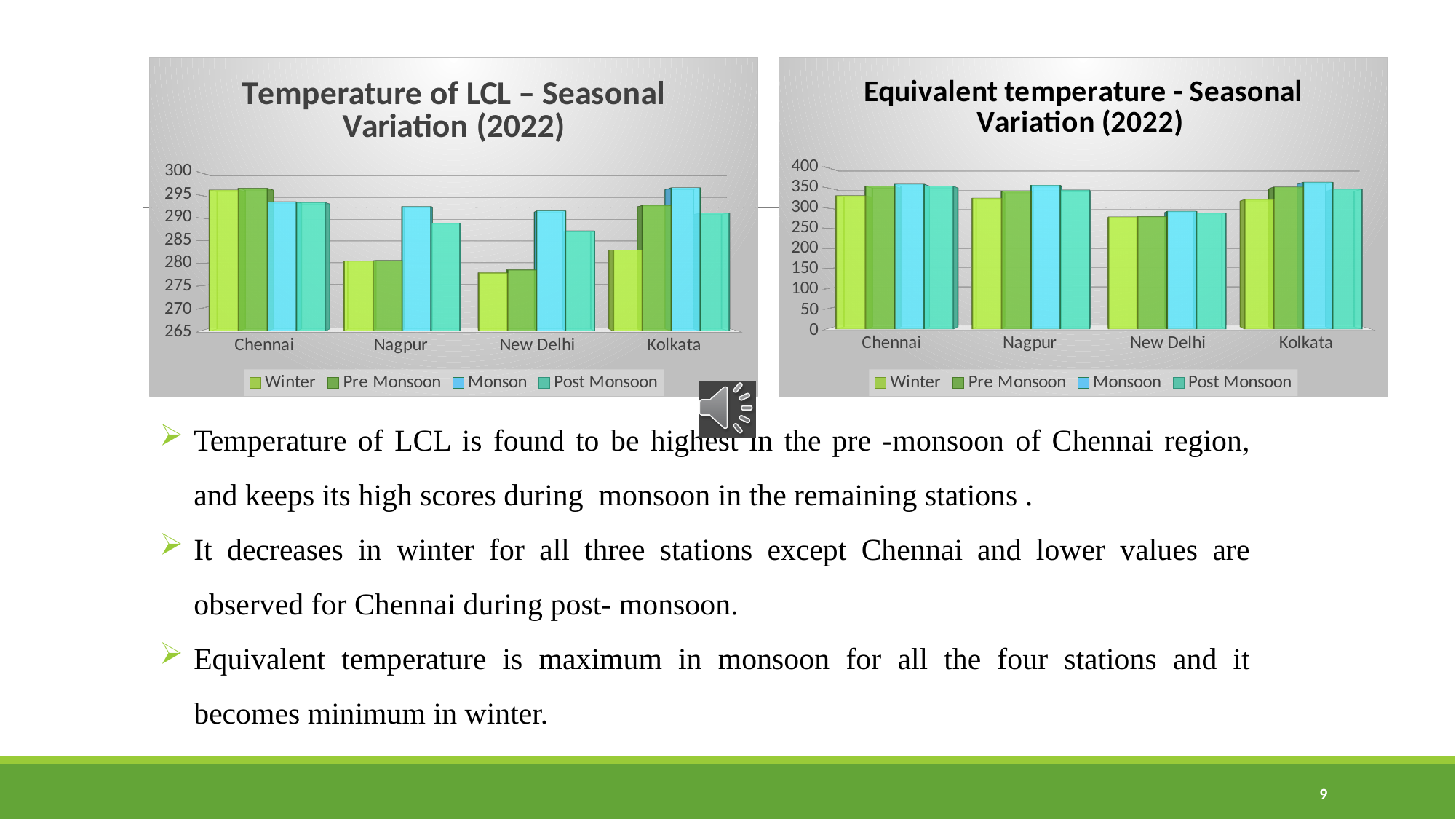
How many series does the legend of the 'Equivalent temperature - Seasonal Variation (2022)' chart list? 4 In the 'Equivalent temperature - Seasonal Variation (2022)' chart, is the Winter value for New Delhi greater or less than 300? less In the 'Temperature of LCL – Seasonal Variation (2022)' chart, which station has the lowest Winter value? New Delhi In the 'Equivalent temperature - Seasonal Variation (2022)' chart, which station has the larger Winter value: Chennai or New Delhi? Chennai In the 'Equivalent temperature - Seasonal Variation (2022)' chart, is the Winter value for Nagpur greater or less than 300? greater In the 'Temperature of LCL – Seasonal Variation (2022)' chart, which is larger for Kolkata: the Winter value or the Monson value? Monson In the 'Equivalent temperature - Seasonal Variation (2022)' chart, which station has the lowest Monsoon value? New Delhi How many stations are shown on the x axis of the 'Temperature of LCL – Seasonal Variation (2022)' chart? 4 What kind of chart is the 'Temperature of LCL – Seasonal Variation (2022)' chart? bar chart In the 'Temperature of LCL – Seasonal Variation (2022)' chart, is the Winter value for New Delhi greater or less than 280? less What is the title of the chart on the right side of the slide? Equivalent temperature - Seasonal Variation (2022)